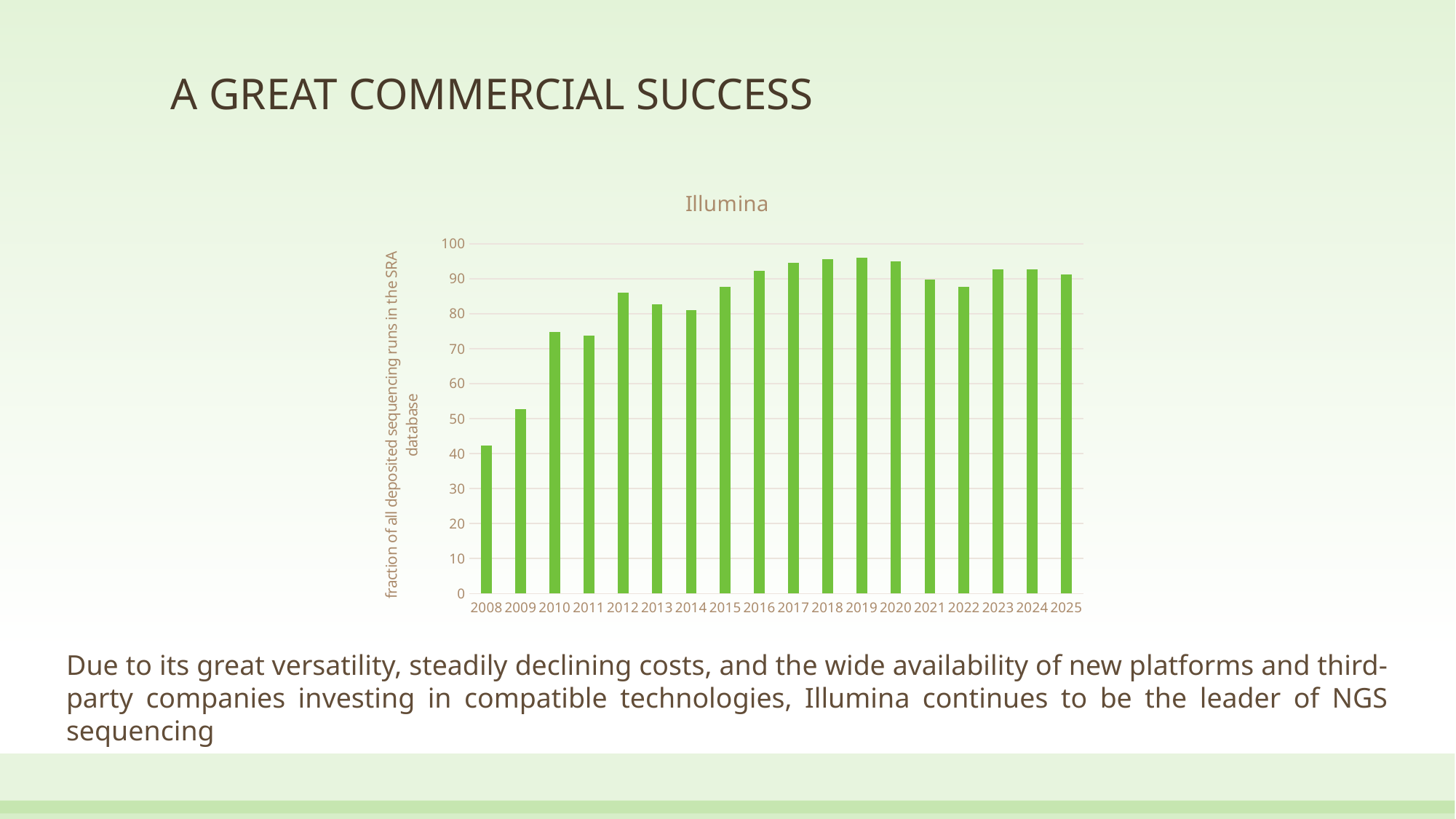
Is the value for 2019 greater or less than 90? greater How many years are plotted on the x axis of the chart? 18 What is the title of the chart? Illumina What colour are the bars in the chart? green Is the value for 2008 greater or less than 50? less Which year has the lowest value in the chart? 2008 Is the value for 2009 greater or less than 50? greater Which year has the larger value, 2014 or 2015? 2015 What kind of chart is shown on the slide? bar chart Do the values generally rise or fall from 2008 to 2012? rise